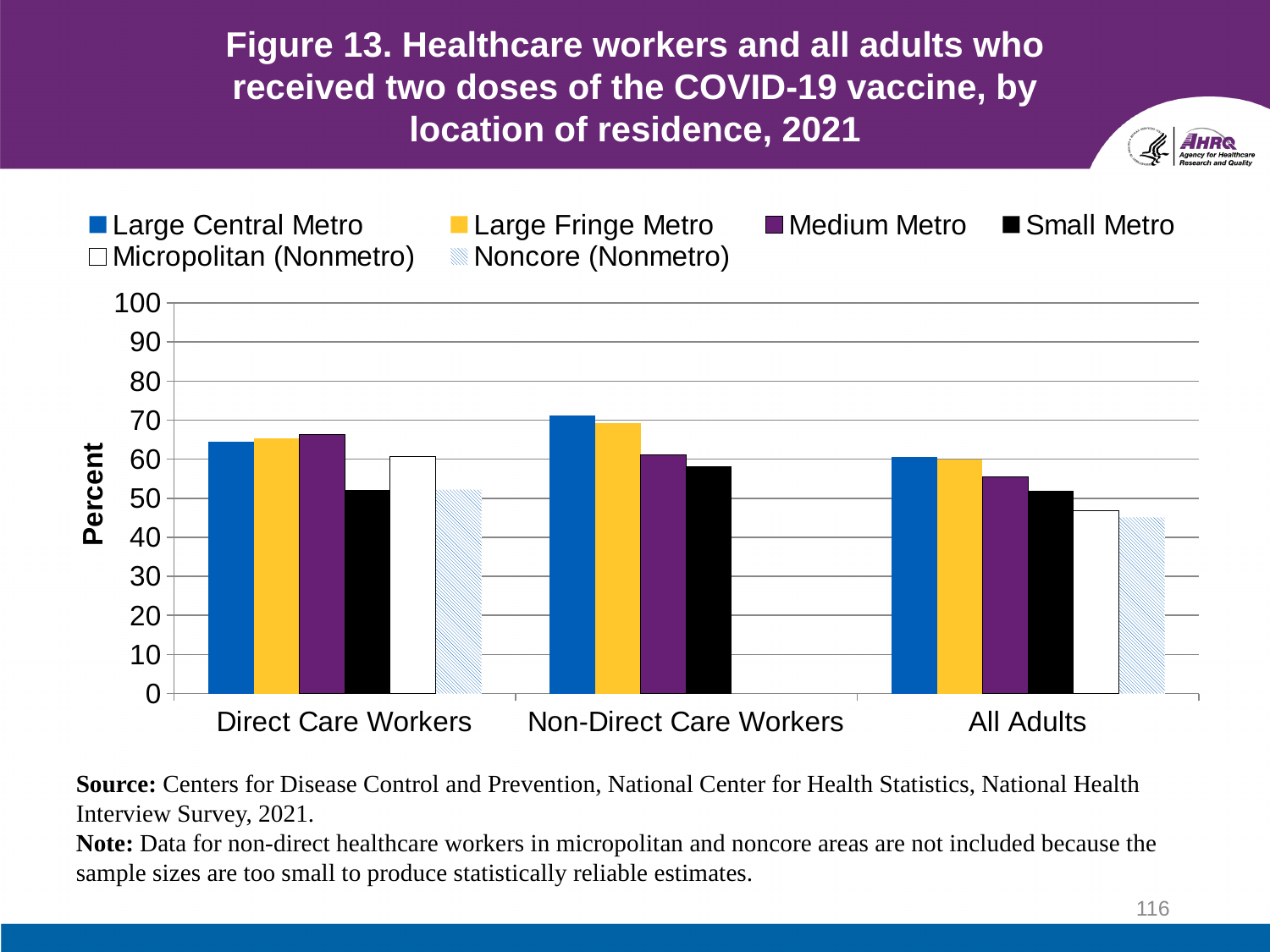
How many series does the legend list? 6 Is the value for Micropolitan (Nonmetro) among Direct Care Workers greater or less than 50? greater Is the value for Noncore (Nonmetro) among All Adults greater or less than 50? less Among All Adults, which is larger: Large Central Metro or Noncore (Nonmetro)? Large Central Metro What kind of chart is shown on the slide? bar chart Among Non-Direct Care Workers, which location of residence has the lowest value? Small Metro How many categories are shown along the x axis? 3 Is the value for Small Metro among Direct Care Workers greater or less than 60? less How many bars are plotted for the Non-Direct Care Workers category? 4 Among Direct Care Workers, which is larger: Medium Metro or Small Metro? Medium Metro What is the label on the y axis? Percent